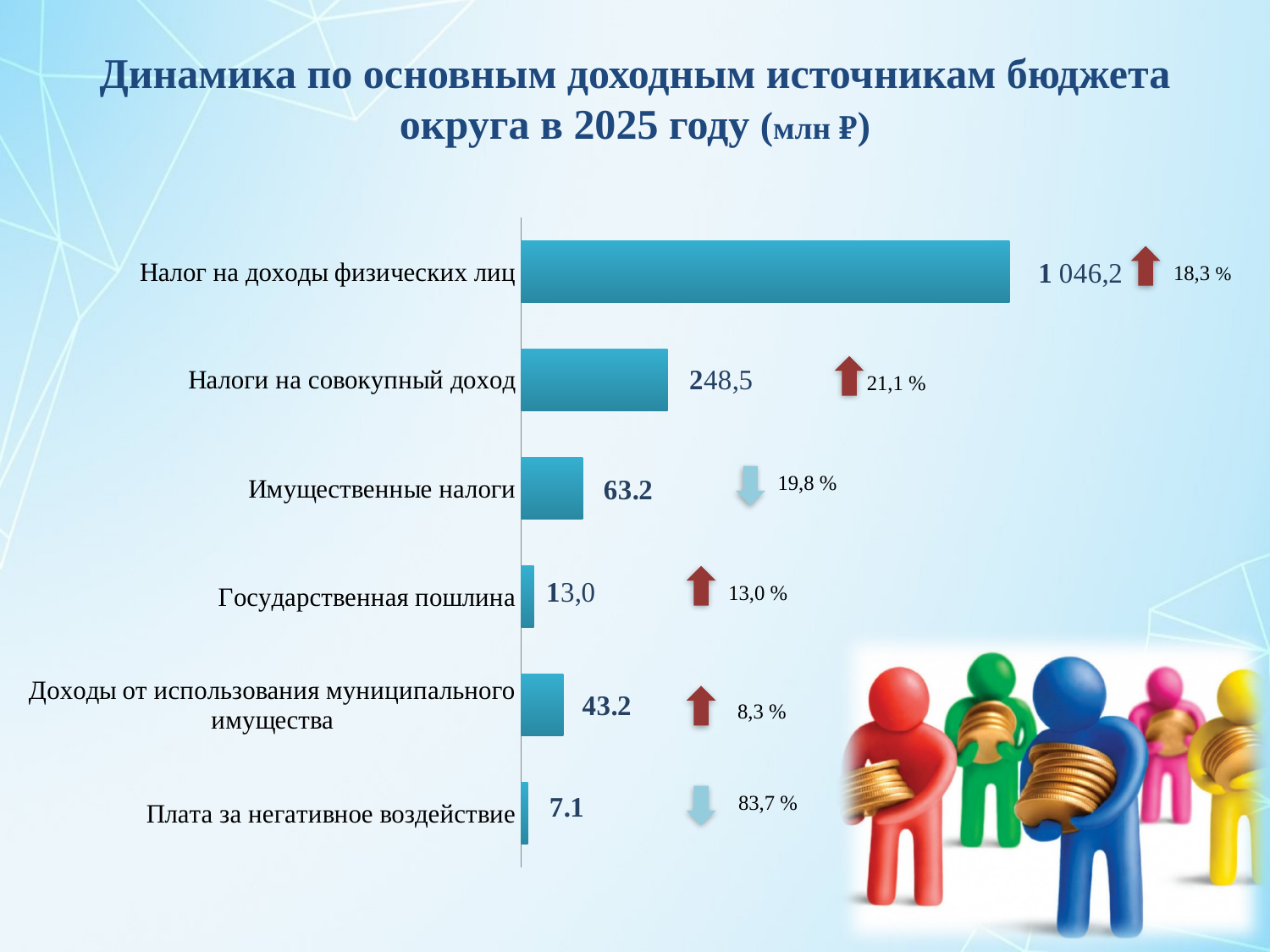
Which category has the lowest value? Плата за негативное воздействие What is the value for Государственная пошлина? 13,0 Which is larger: Имущественные налоги or Доходы от использования муниципального имущества? Имущественные налоги What is the value for Имущественные налоги? 63.2 What percentage change is shown next to the bar for Плата за негативное воздействие? 83,7 % What type of chart is shown on the slide? bar chart What is the difference between Доходы от использования муниципального имущества and Плата за негативное воздействие? 36.1 What is the value for Плата за негативное воздействие? 7.1 What is the value for Налог на доходы физических лиц? 1 046,2 How many categories are shown in the chart? 6 What is the value for Налоги на совокупный доход? 248,5 Which category has the highest value? Налог на доходы физических лиц